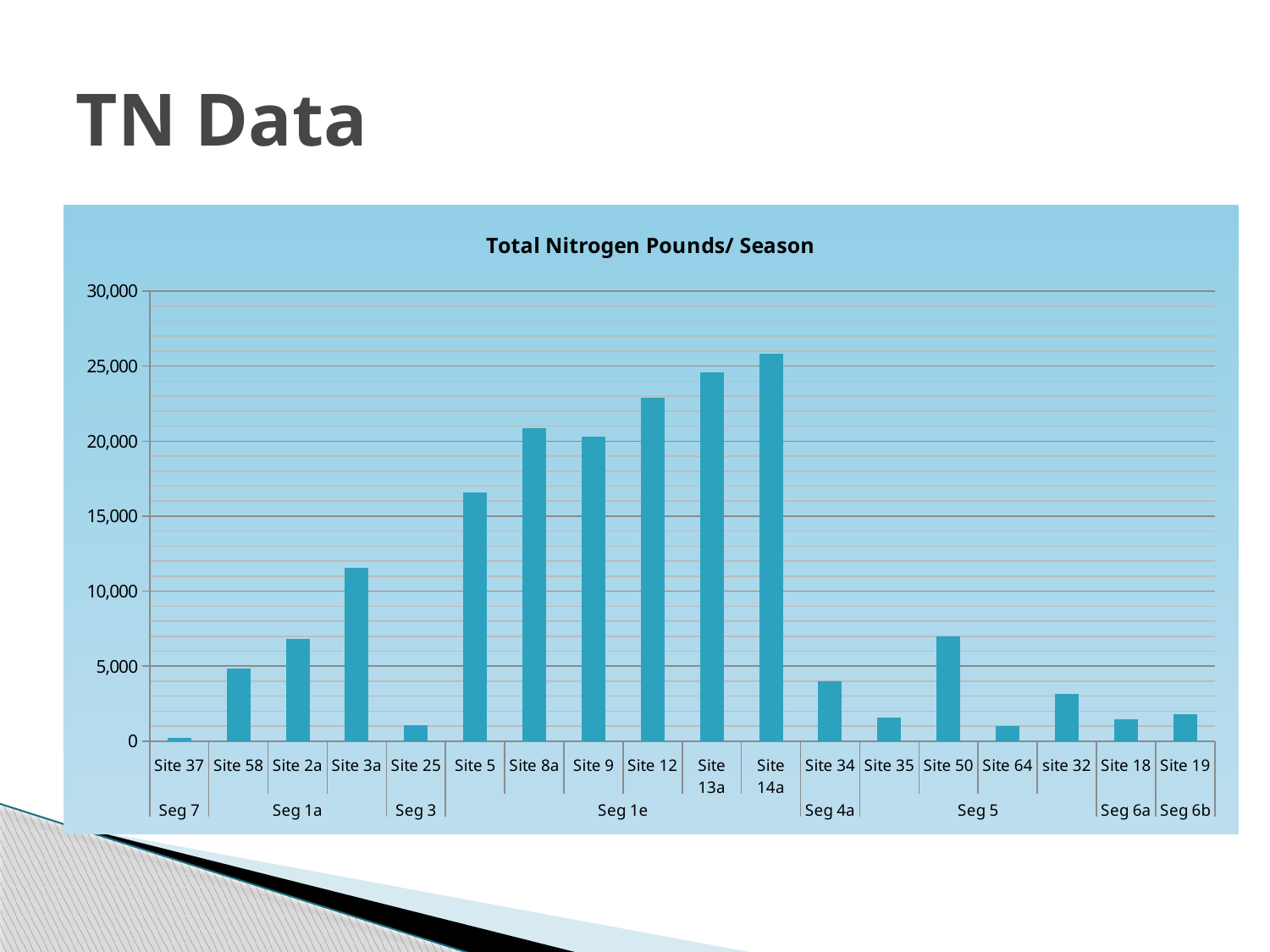
Is the value for Site 50 greater or less than 5,000? greater Is the value for Site 34 greater or less than 5,000? less Is the value for Site 3a greater or less than 10,000? greater What kind of chart is shown on the slide? Bar chart Which has the larger value, Site 2a or Site 58? Site 2a How many sites are plotted on the chart? 18 Which site has the highest total nitrogen value? Site 14a Which site has the lowest total nitrogen value? Site 37 Which has the larger value, Site 13a or Site 12? Site 13a How many segment groups (Seg labels) are shown along the x axis? 8 What is the title of the chart? Total Nitrogen Pounds/ Season